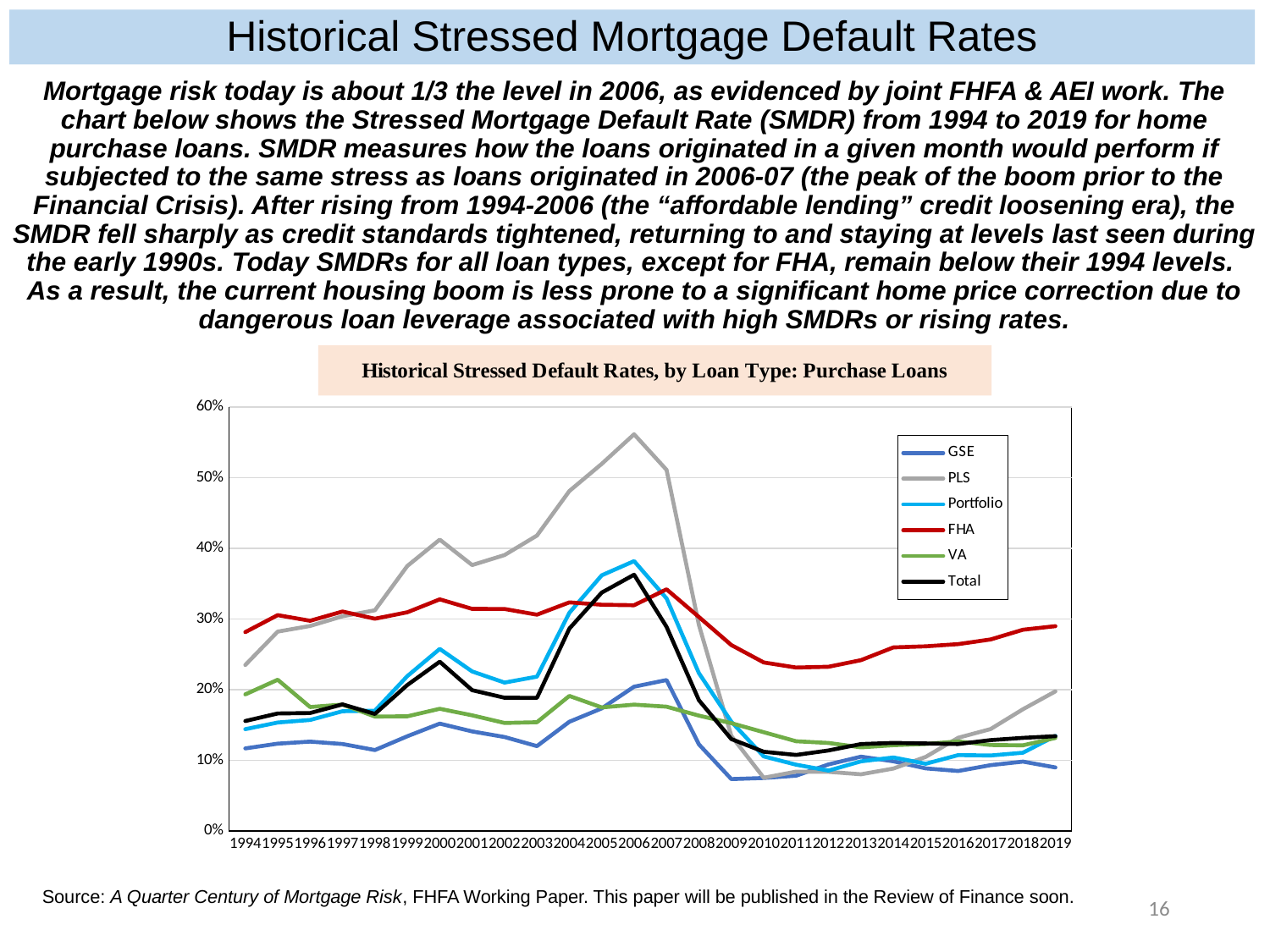
What kind of chart is shown on the slide? line chart What is the title of the chart? Historical Stressed Default Rates, by Loan Type: Purchase Loans Is the value for GSE in 2009 greater or less than 10%? less Which loan type has the lowest stressed default rate in 2019? GSE How many series does the chart's legend list? 6 Is the value for PLS in 2006 greater or less than 50%? greater Which loan type has the highest stressed default rate in 2019? FHA Which loan type has the highest stressed default rate in 2006? PLS Which series in the legend is drawn in red? FHA In 2019, which is higher, FHA or PLS? FHA Does the PLS line rise or fall between 2006 and 2009? fall How many years are shown along the x axis of the chart? 26